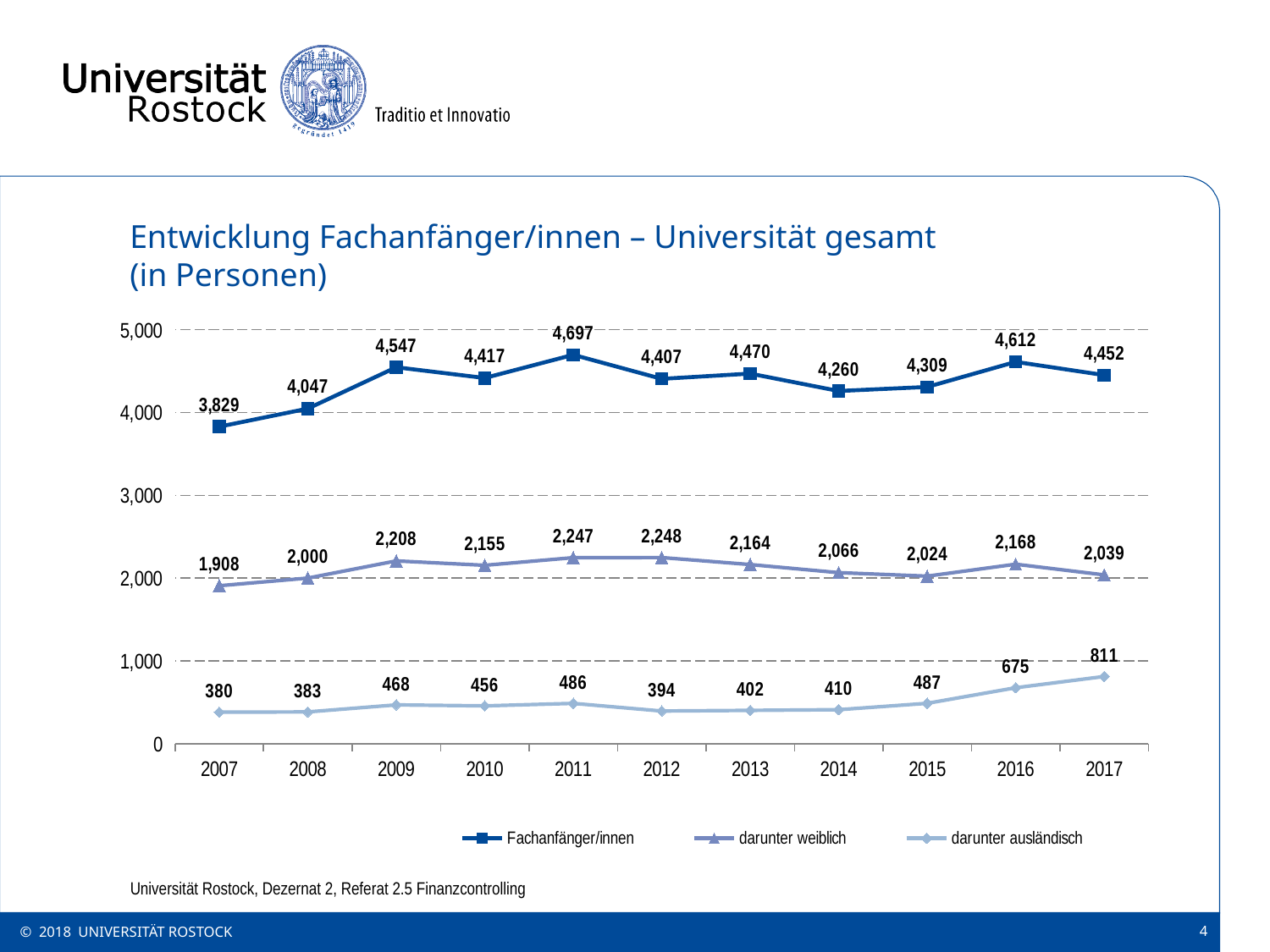
Does the value for darunter ausländisch rise or fall from 2015 to 2017? rise What is the value for darunter ausländisch in 2017? 811 What is the difference between the Fachanfänger/innen values for 2017 and 2007? 623 How many series does the legend list? 3 In which year is the value for darunter ausländisch the highest? 2017 What is the value for Fachanfänger/innen in 2011? 4,697 What is the value for darunter weiblich in 2014? 2,066 What is the title of the chart? Entwicklung Fachanfänger/innen – Universität gesamt (in Personen) What type of chart is shown on the slide? line chart How many years are shown on the x axis? 11 Which is larger: the darunter weiblich value in 2009 or in 2016? 2009 In which year is the value for Fachanfänger/innen the lowest? 2007